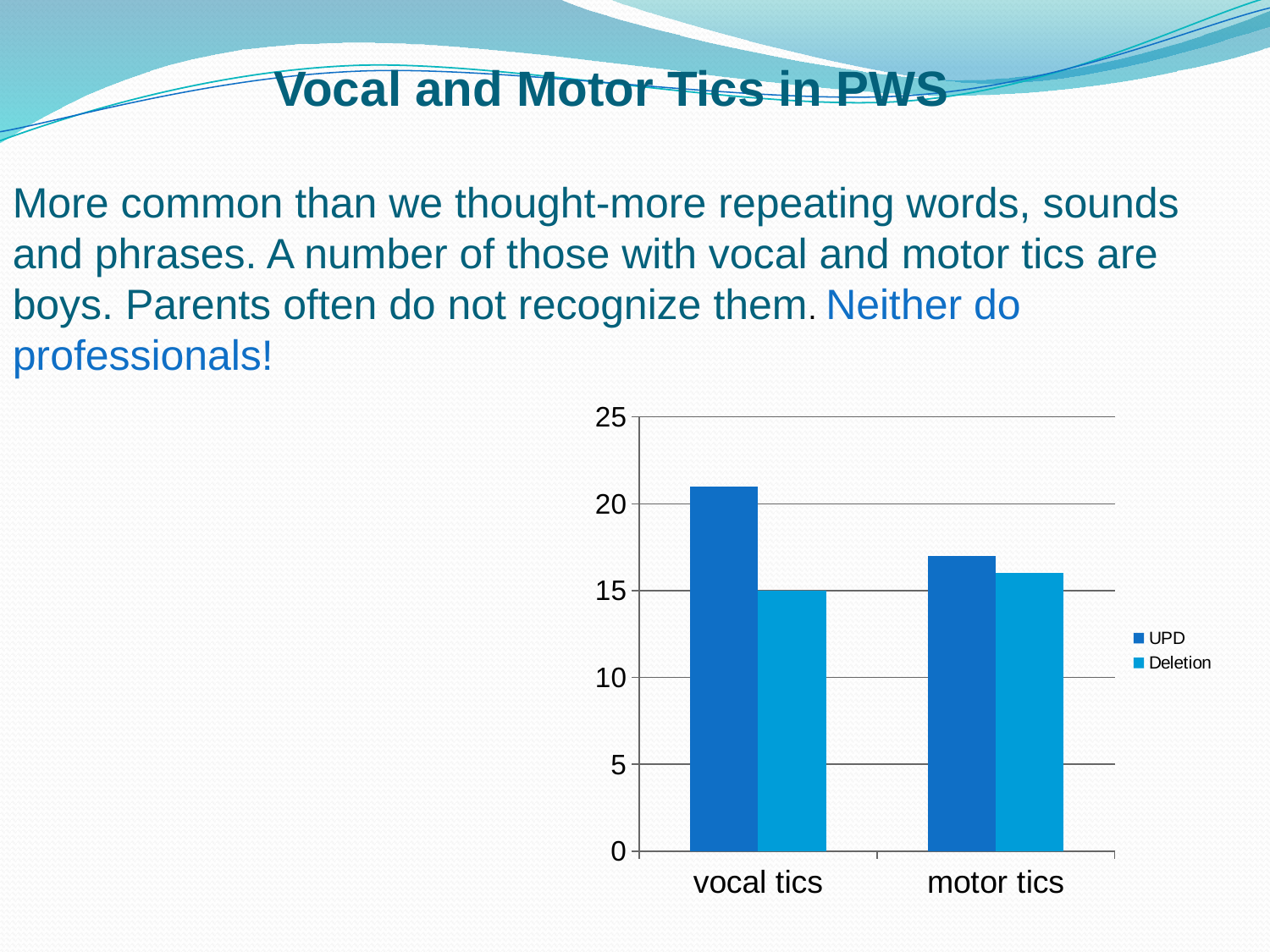
How many series does the chart's legend list? 2 What are the two series named in the chart's legend? UPD and Deletion Is the UPD value for motor tics greater or less than 15? greater Is the UPD value for motor tics greater or less than 20? less Is the UPD value for vocal tics greater or less than 20? greater How many categories are shown on the x axis of the chart? 2 Which series is shown in the darker blue bars in the chart? UPD What kind of chart is shown on the slide? bar chart Which category has the tallest bar in the chart? vocal tics For vocal tics, which series has the larger value, UPD or Deletion? UPD